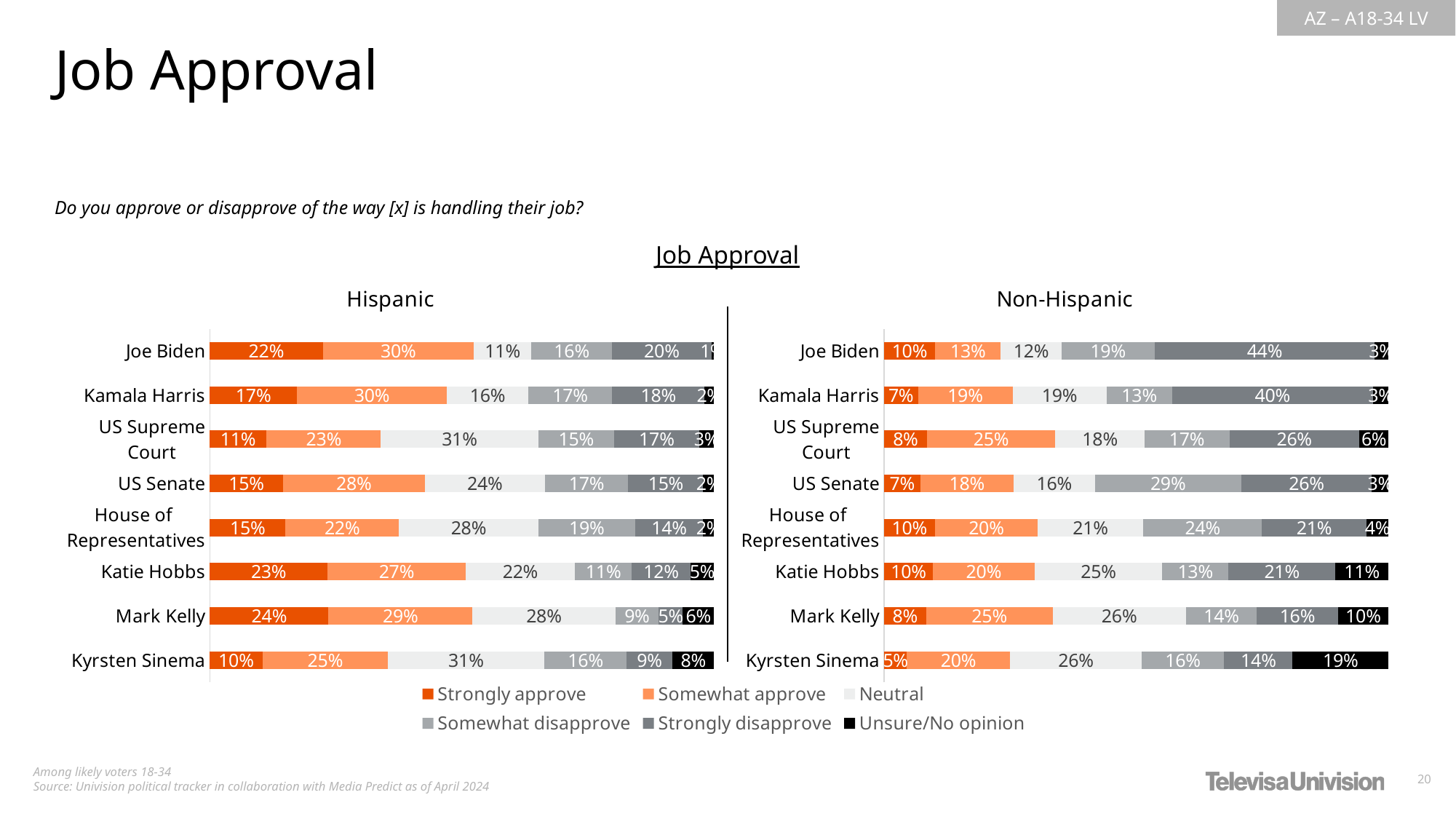
In the Hispanic chart, what is the combined Strongly approve and Somewhat approve value for Katie Hobbs? 50% How many series does the legend list? 6 In the Non-Hispanic chart, what is the Unsure/No opinion value for Kyrsten Sinema? 19% In the Hispanic chart, what percentage strongly approve of Mark Kelly? 24% In the Non-Hispanic chart, what is the difference between the Strongly disapprove values for Joe Biden and Kamala Harris? 4% In the Non-Hispanic chart, what percentage strongly disapprove of Joe Biden? 44% In the Hispanic chart, which category has the highest Strongly approve value? Mark Kelly In the Non-Hispanic chart, which category has the lowest Strongly approve value? Kyrsten Sinema Which legend entry is shown in black? Unsure/No opinion How many categories (people or institutions) are shown in the Non-Hispanic chart? 8 What kind of chart is used for the Hispanic and Non-Hispanic panels? Stacked bar chart In the Hispanic chart, which is larger: the Neutral value for the US Supreme Court or the Neutral value for the US Senate? US Supreme Court